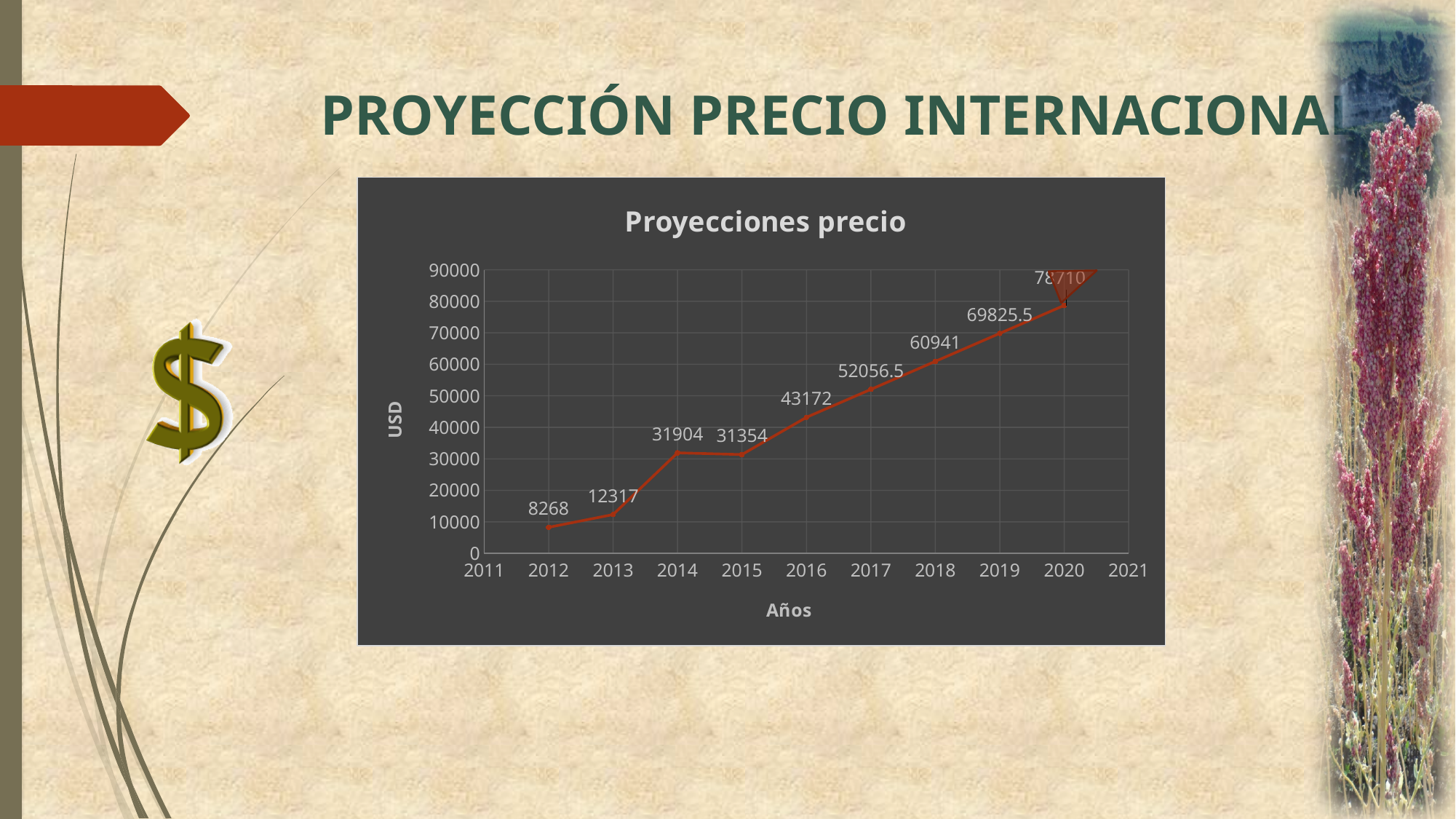
What is the projected price for 2017? 52056.5 How many data points are plotted on the line? 9 What is the title of the chart? Proyecciones precio Is the value for 2020 greater or less than 70000? greater Which year has the larger projected price, 2014 or 2015? 2014 What kind of chart is shown on the slide? line chart What is the label of the vertical axis? USD Which year has the lowest projected price? 2012 What is the difference between the projected prices for 2013 and 2012? 4049 What is the projected price for 2019? 69825.5 What is the projected price for 2012? 8268 Which year has the highest projected price? 2020